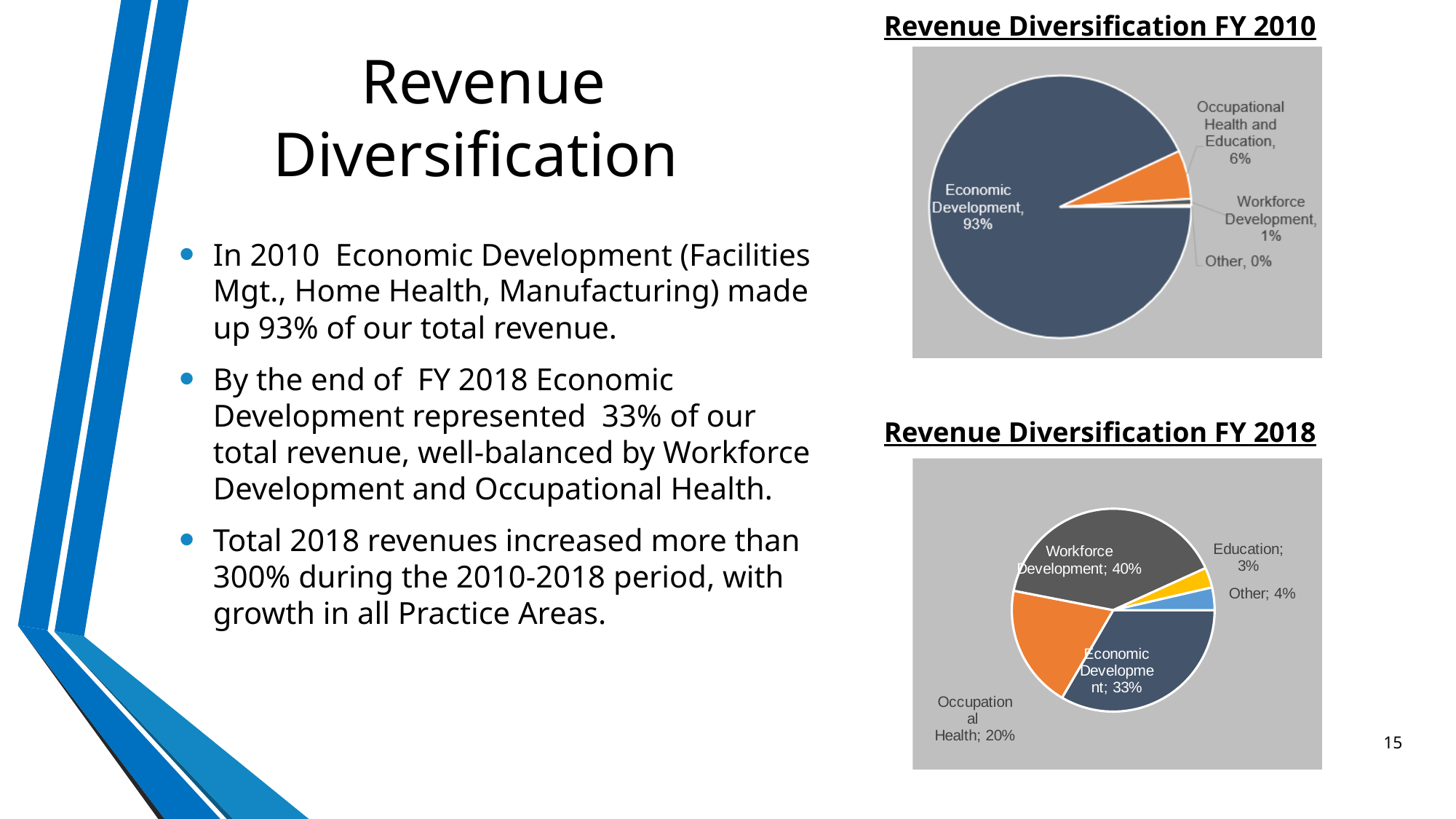
In the Revenue Diversification FY 2010 chart, what share of revenue is Economic Development? 93% In the Revenue Diversification FY 2018 chart, what share of revenue is Workforce Development? 40% In the Revenue Diversification FY 2018 chart, what share of revenue is Occupational Health? 20% In the Revenue Diversification FY 2018 chart, which category has the largest share? Workforce Development In the Revenue Diversification FY 2018 chart, which category has the smallest share? Education In the Revenue Diversification FY 2010 chart, what share of revenue is Occupational Health and Education? 6% In the Revenue Diversification FY 2010 chart, what share of revenue is Workforce Development? 1% What type of chart is the Revenue Diversification FY 2010 chart? Pie chart In the Revenue Diversification FY 2010 chart, which category has the smallest share? Other In the Revenue Diversification FY 2010 chart, which category has the largest share? Economic Development In the Revenue Diversification FY 2018 chart, what is the difference between the Workforce Development and Economic Development shares? 7% How many categories are shown in the Revenue Diversification FY 2018 chart? 5